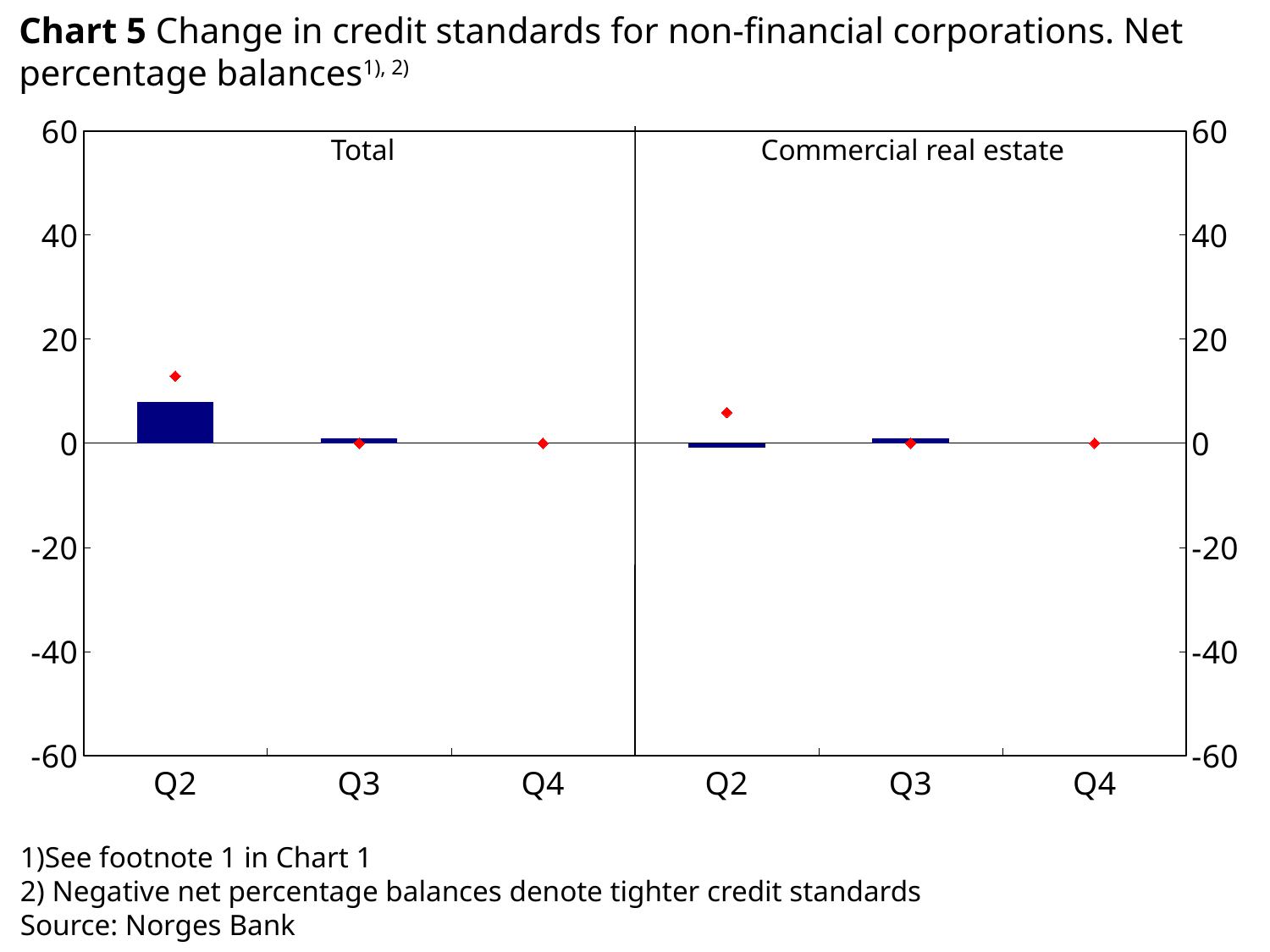
How many quarters are shown in the Total panel of the chart? 3 Is the red marker for Q2 in the Total panel greater or less than 20? less Is the bar for Q2 in the Commercial real estate panel above or below 0? below Is the bar for Q2 in the Total panel greater or less than 0? greater What are the two panels of the chart labelled? Total and Commercial real estate Which quarter has the highest bar in the Total panel? Q2 What is the source given for the chart? Norges Bank Do the bars in the Total panel rise or fall from Q2 to Q4? fall In the Total panel, which bar is larger, Q2 or Q3? Q2 What kind of chart is Chart 5? bar chart with red diamond markers